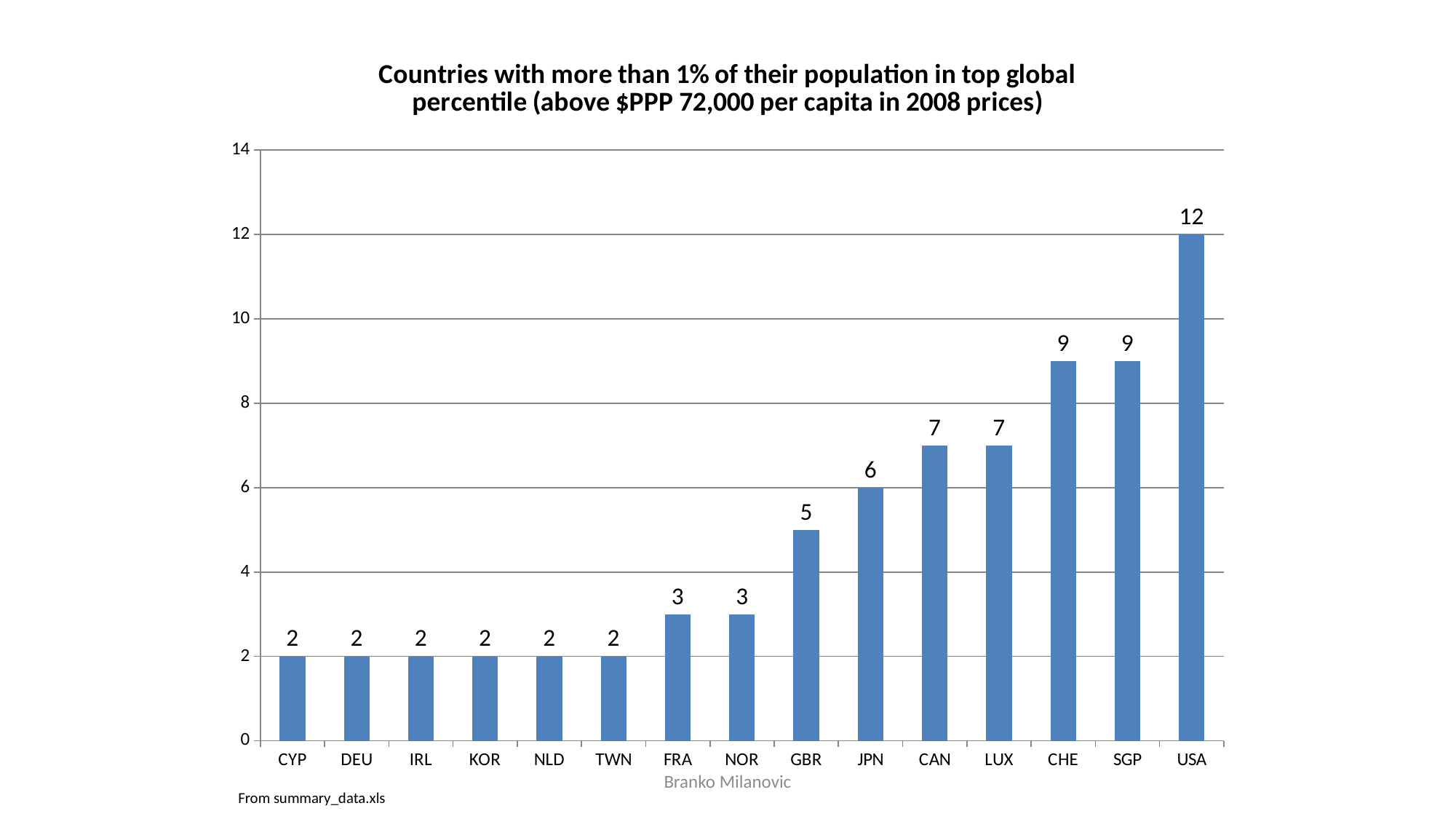
What kind of chart is this? bar chart Which is larger, the value for GBR or the value for NOR? GBR What is the value for GBR? 5 What is the title of the chart? Countries with more than 1% of their population in top global percentile (above $PPP 72,000 per capita in 2008 prices) Do the values rise or fall from left to right along the x axis? rise How many countries are shown on the x axis? 15 What is the difference between the values for CAN and FRA? 4 What is the value for JPN? 6 Which country has the highest value? USA Is the value for SGP greater or less than 8? greater What is the difference between the values for USA and CHE? 3 What is the value for USA? 12